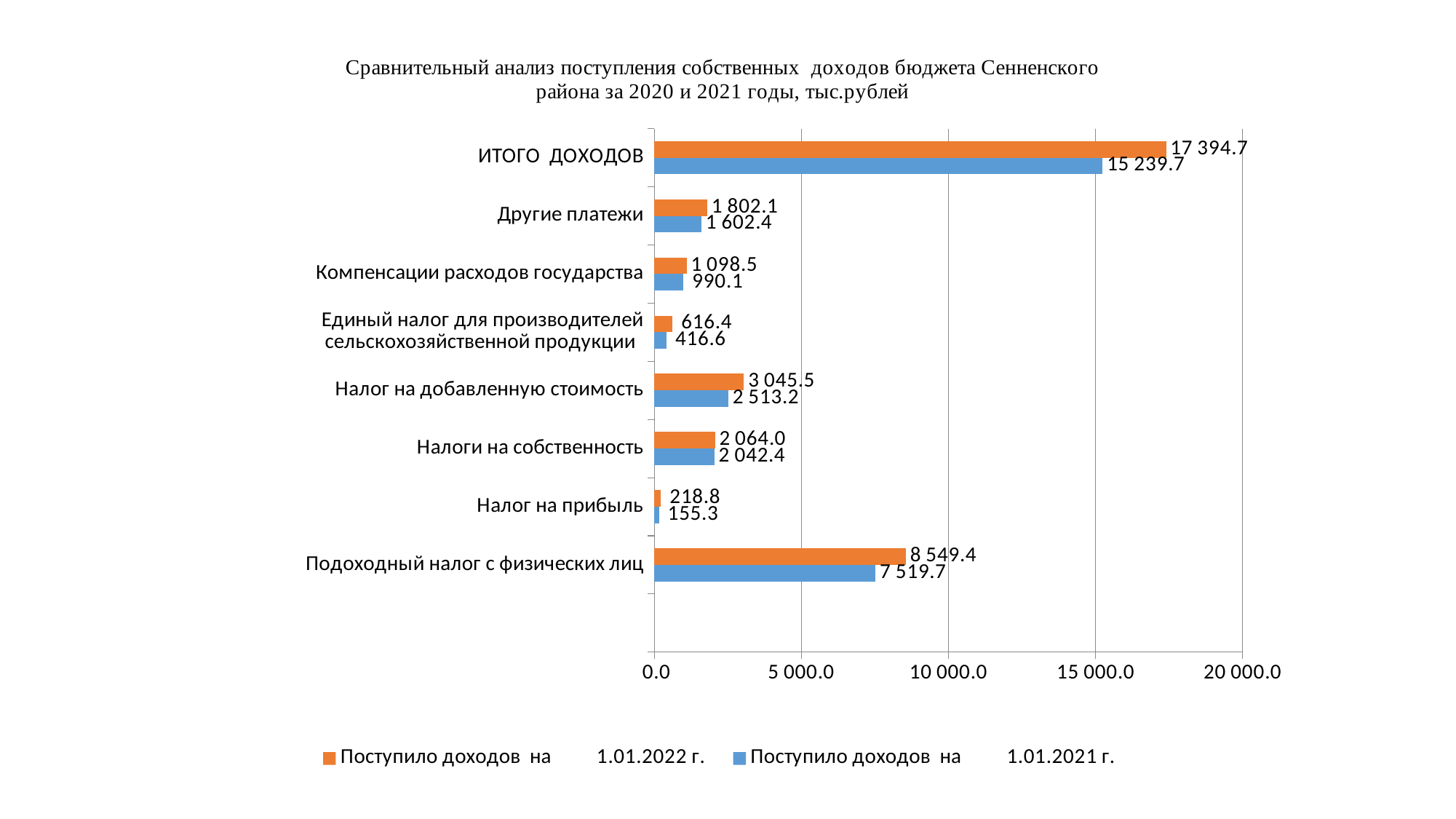
What is the value for ИТОГО ДОХОДОВ in the series 'Поступило доходов на 1.01.2022 г.'? 17 394.7 What is the difference between the 1.01.2022 and 1.01.2021 values for Подоходный налог с физических лиц? 1 029.7 What is the difference between the 1.01.2022 and 1.01.2021 values for ИТОГО ДОХОДОВ? 2 155.0 What is the value for Подоходный налог с физических лиц in the series 'Поступило доходов на 1.01.2021 г.'? 7 519.7 Excluding ИТОГО ДОХОДОВ, which category has the lowest value in the series 'Поступило доходов на 1.01.2021 г.'? Налог на прибыль How many series does the legend list? 2 What type of chart is shown on the slide? Bar chart Excluding ИТОГО ДОХОДОВ, which category has the highest value in the series 'Поступило доходов на 1.01.2022 г.'? Подоходный налог с физических лиц Which is larger for Налог на добавленную стоимость: the value on 1.01.2022 or on 1.01.2021? 1.01.2022 What is the value for Налоги на собственность in the series 'Поступило доходов на 1.01.2021 г.'? 2 042.4 What is the value for Налог на прибыль in the series 'Поступило доходов на 1.01.2022 г.'? 218.8 How many categories are shown on the chart? 8